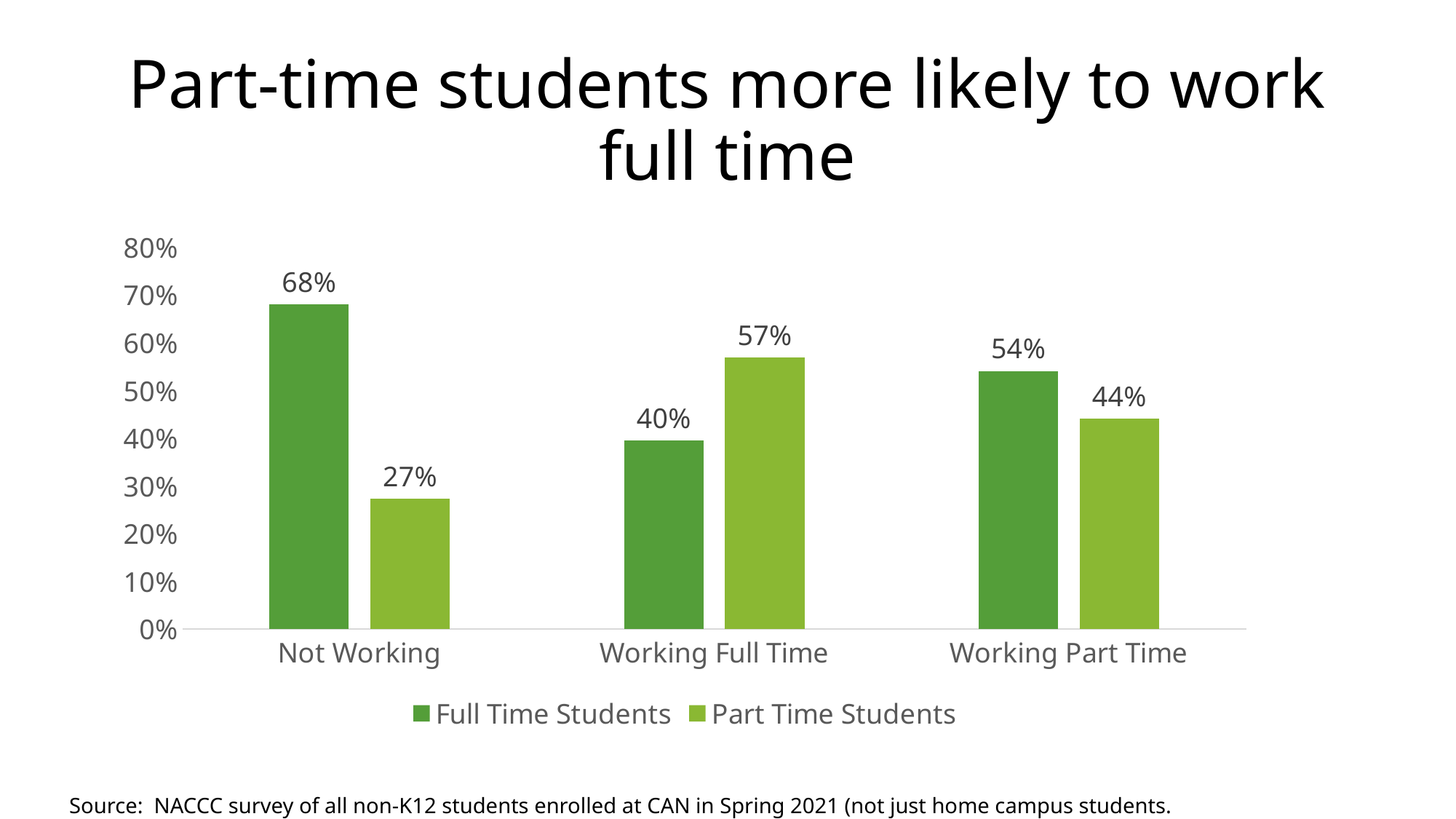
Which category has the highest value for Full Time Students? Not Working What percentage of Full Time Students are Working Part Time? 54% What percentage of Part Time Students are Working Full Time? 57% What is the difference between Full Time Students and Part Time Students in the Not Working category? 41% What percentage of Full Time Students are Not Working? 68% How many categories are shown on the x axis? 3 What kind of chart is shown on the slide? Bar chart How many series does the legend list? 2 What is the title of the chart? Part-time students more likely to work full time In the Working Full Time category, which series has the larger value, Full Time Students or Part Time Students? Part Time Students What percentage of Part Time Students are Not Working? 27% Which category has the lowest value for Part Time Students? Not Working